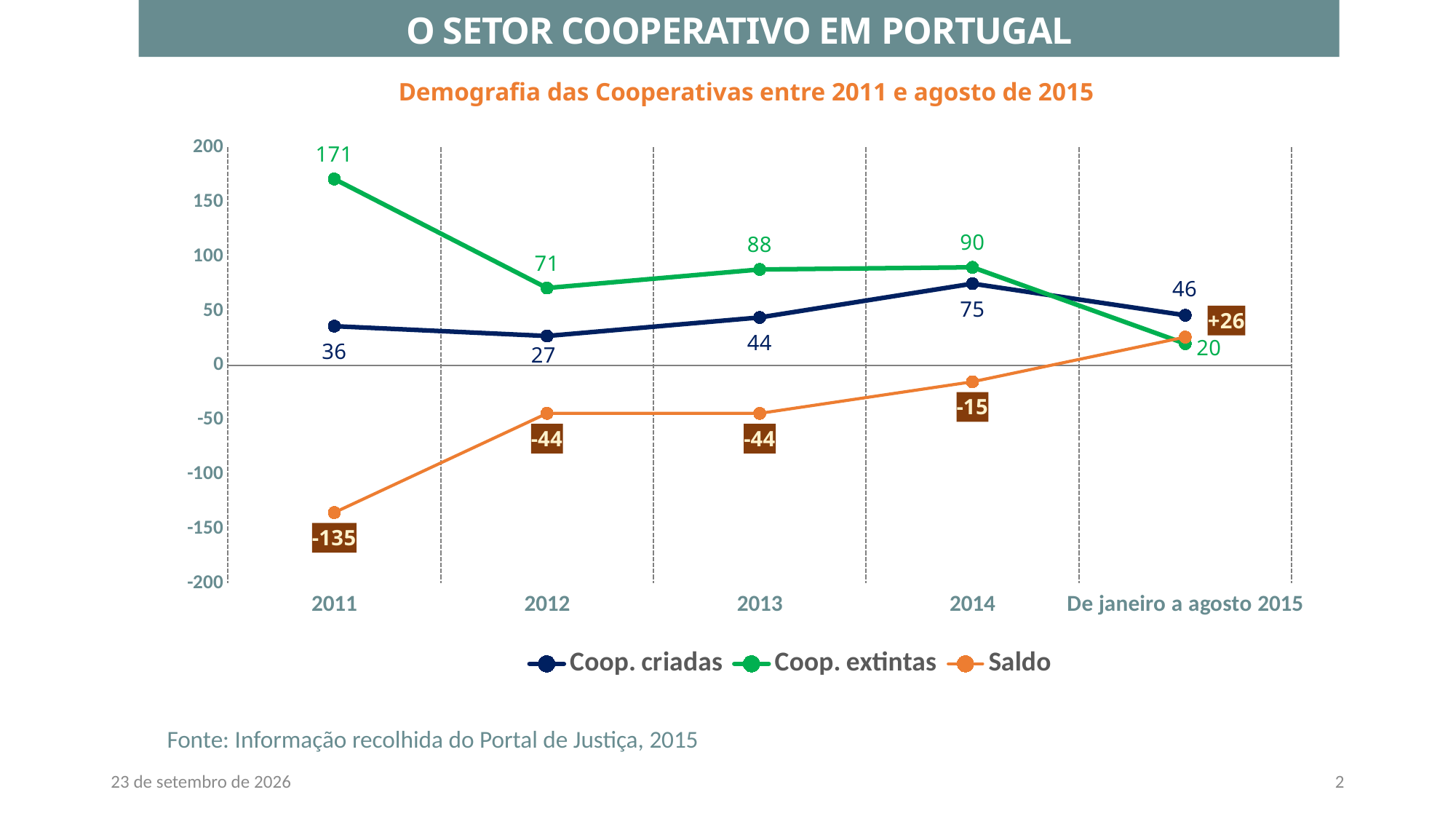
Does the Saldo series rise or fall from 2011 to De janeiro a agosto 2015? Rise In which year is Coop. extintas highest? 2011 What is the Saldo value for De janeiro a agosto 2015? +26 Which is larger in De janeiro a agosto 2015, Coop. criadas or Coop. extintas? Coop. criadas What is the value of Coop. criadas in 2014? 75 How many categories are shown on the x axis? 5 How many series does the legend list? 3 In which period is Coop. criadas lowest? 2012 What is the Saldo value for 2011? -135 What is the value of Coop. extintas in 2011? 171 What is the difference between Coop. extintas and Coop. criadas in 2011? 135 What kind of chart is shown? Line chart